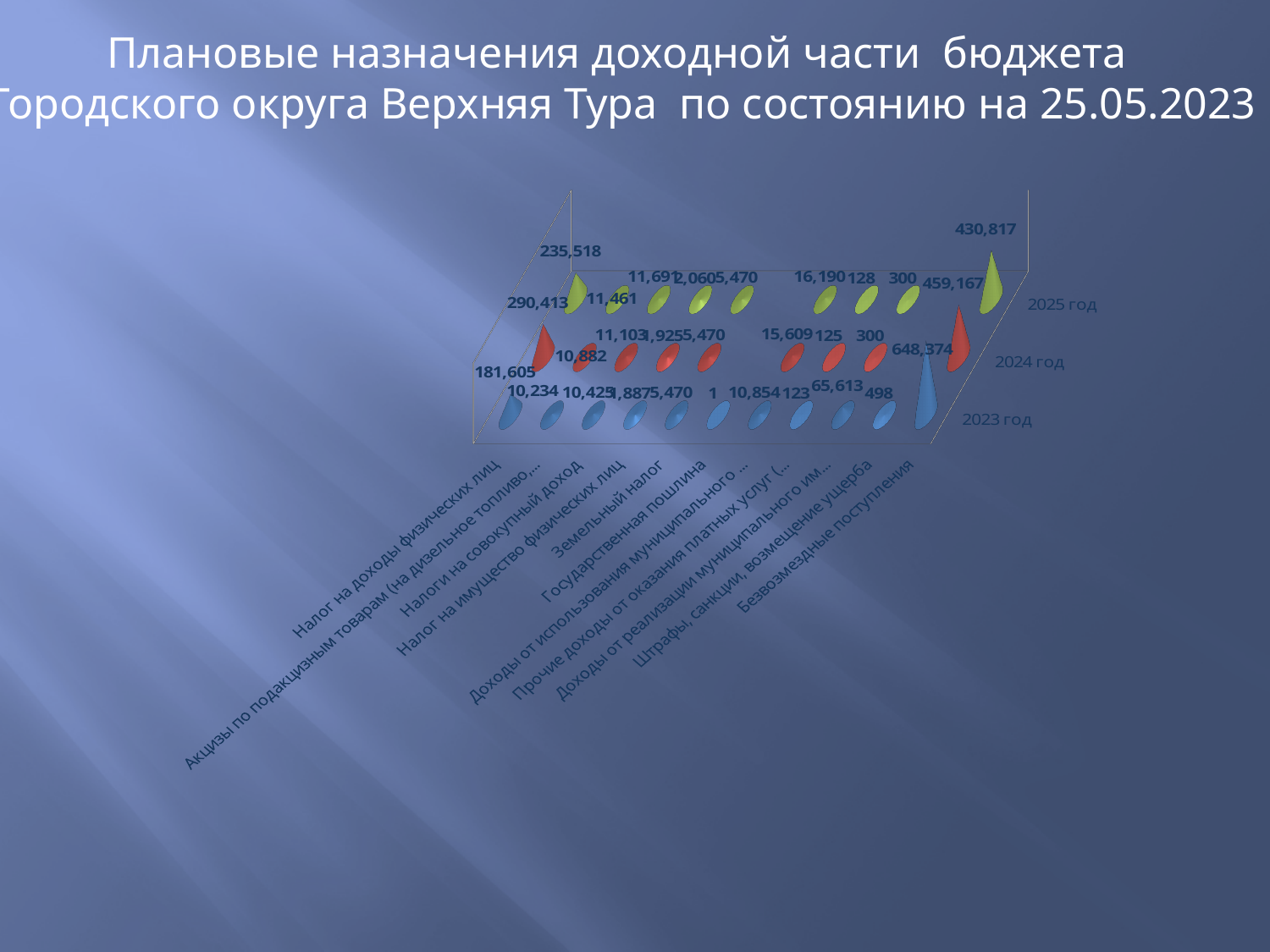
How many series (years) does the chart show? 3 What is the difference between the 2025 год and 2023 год values for Акцизы по подакцизным товарам? 1,227 Which category has the highest value for 2023 год? Безвозмездные поступления What is the value for Земельный налог in 2023 год? 5,470 What is the planned value for Налог на доходы физических лиц in 2023 год? 181,605 What type of chart is shown on the slide? 3D bar chart Do the values for Доходы от оказания платных услуг rise or fall from 2023 год to 2025 год? rise What is the planned value for Безвозмездные поступления in 2023 год? 648,374 What are the three series labels shown on the chart? 2023 год, 2024 год, 2025 год For Налог на доходы физических лиц, which year has the larger planned value: 2024 год or 2025 год? 2024 год How many revenue categories are listed along the category axis? 11 What is the planned value for Безвозмездные поступления in 2025 год? 430,817